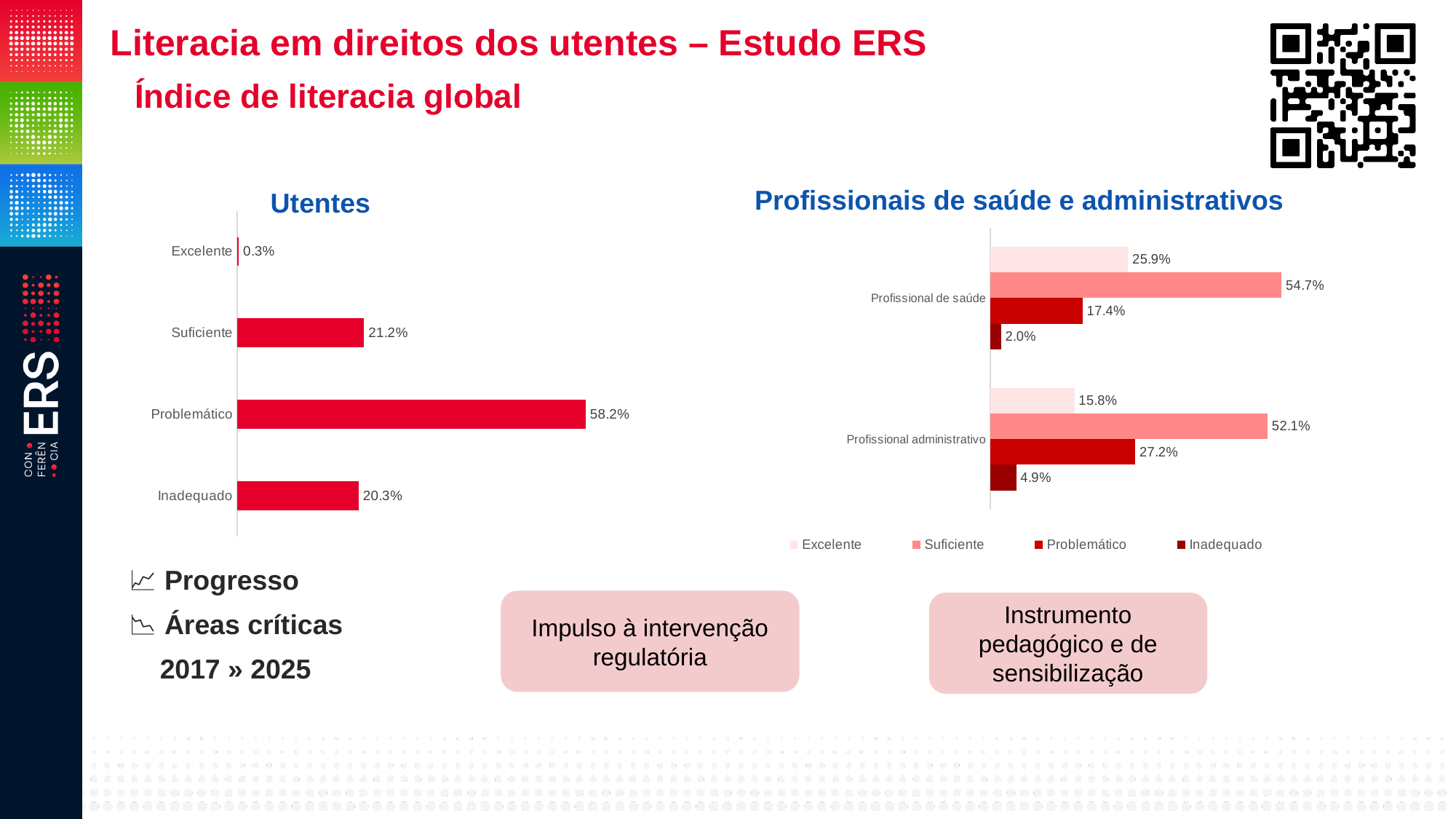
In the 'Utentes' chart, which category has the lowest value? Excelente In the 'Utentes' chart, what is the difference between Suficiente and Inadequado? 0.9% In the 'Profissionais de saúde e administrativos' chart, which group has the larger Problemático value, Profissional de saúde or Profissional administrativo? Profissional administrativo What kind of chart is the 'Utentes' chart? Bar chart In the 'Profissionais de saúde e administrativos' chart, what is the Suficiente value for Profissional de saúde? 54.7% How many series does the legend of the 'Profissionais de saúde e administrativos' chart list? 4 In the 'Profissionais de saúde e administrativos' chart, what is the Inadequado value for Profissional administrativo? 4.9% In the 'Profissionais de saúde e administrativos' chart, which series is shown in the lightest pink colour? Excelente In the 'Utentes' chart, what is the value for Problemático? 58.2% In the 'Utentes' chart, which category has the highest value? Problemático In the 'Utentes' chart, how many categories are shown? 4 In the 'Profissionais de saúde e administrativos' chart, what is the difference between the Excelente values for Profissional de saúde and Profissional administrativo? 10.1%